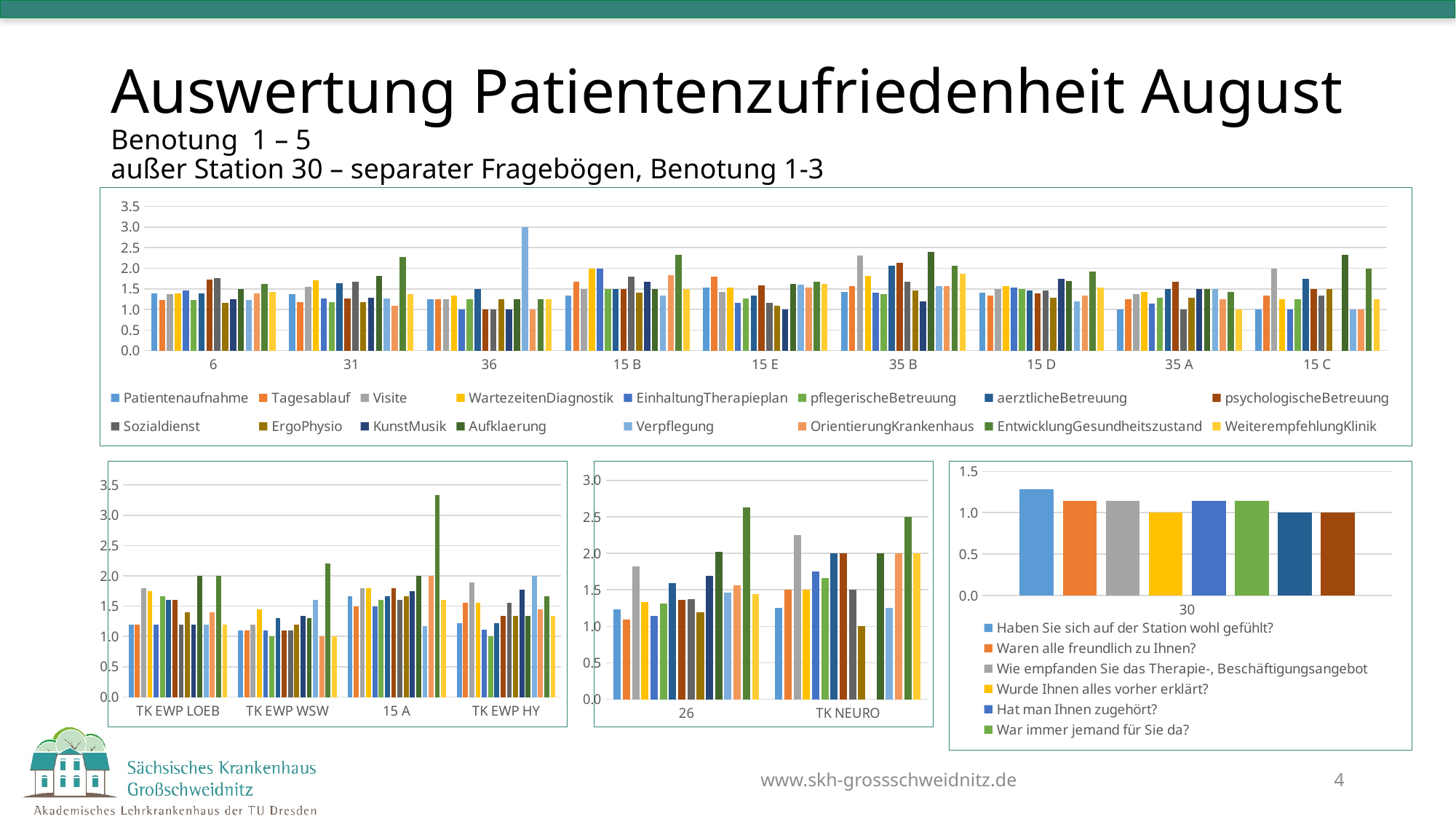
How many categories are shown on the x axis of the top chart? 9 How many series does the legend of the top chart list? 16 In the bottom-left chart, is the tallest bar for 15 A greater or less than 3.0? greater How many series does the legend of the bottom-right chart list? 6 In the top chart, is the value of Aufklaerung for station 35 B greater or less than 2.0? greater What is the category label on the x axis of the bottom-right chart? 30 In the bottom-right chart, which series has the highest value for station 30? Haben Sie sich auf der Station wohl gefühlt? What kind of chart is the large chart at the top of the slide? bar chart In the top chart, is the value of Verpflegung for station 36 greater or less than 2.5? greater How many categories are shown on the x axis of the bottom-middle chart? 2 How many categories are shown on the x axis of the bottom-left chart? 4